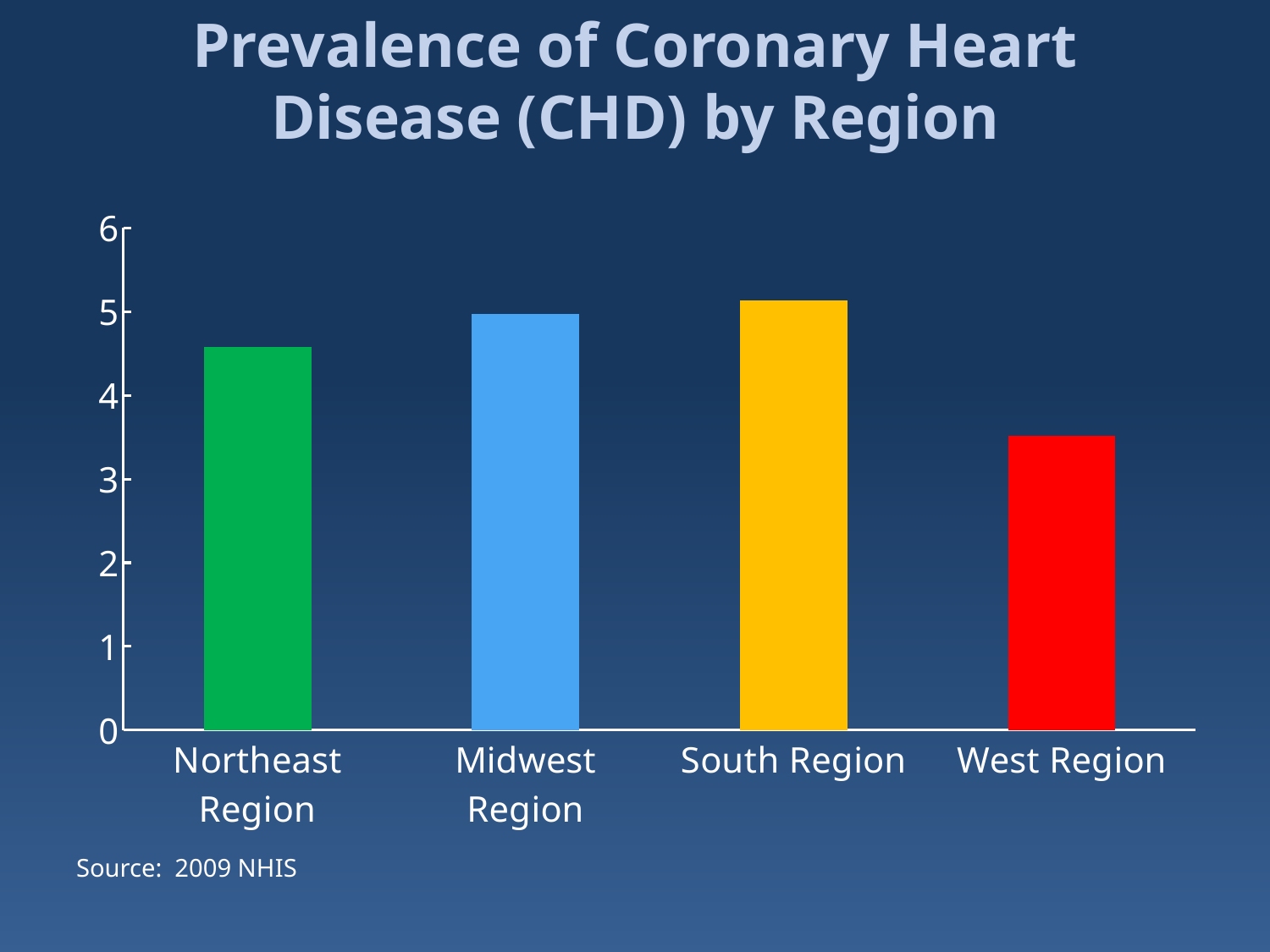
What kind of chart is shown on the slide? bar chart Which is larger, the value for Northeast Region or West Region? Northeast Region How many regions are shown in the chart? 4 Is the value for West Region greater or less than 3? greater What colour is the bar for South Region? yellow Is the value for South Region greater or less than 4? greater Which is larger, the value for Midwest Region or Northeast Region? Midwest Region Which region has the lowest prevalence of CHD? West Region Is the value for Northeast Region greater or less than 5? less What is the title of the chart? Prevalence of Coronary Heart Disease (CHD) by Region